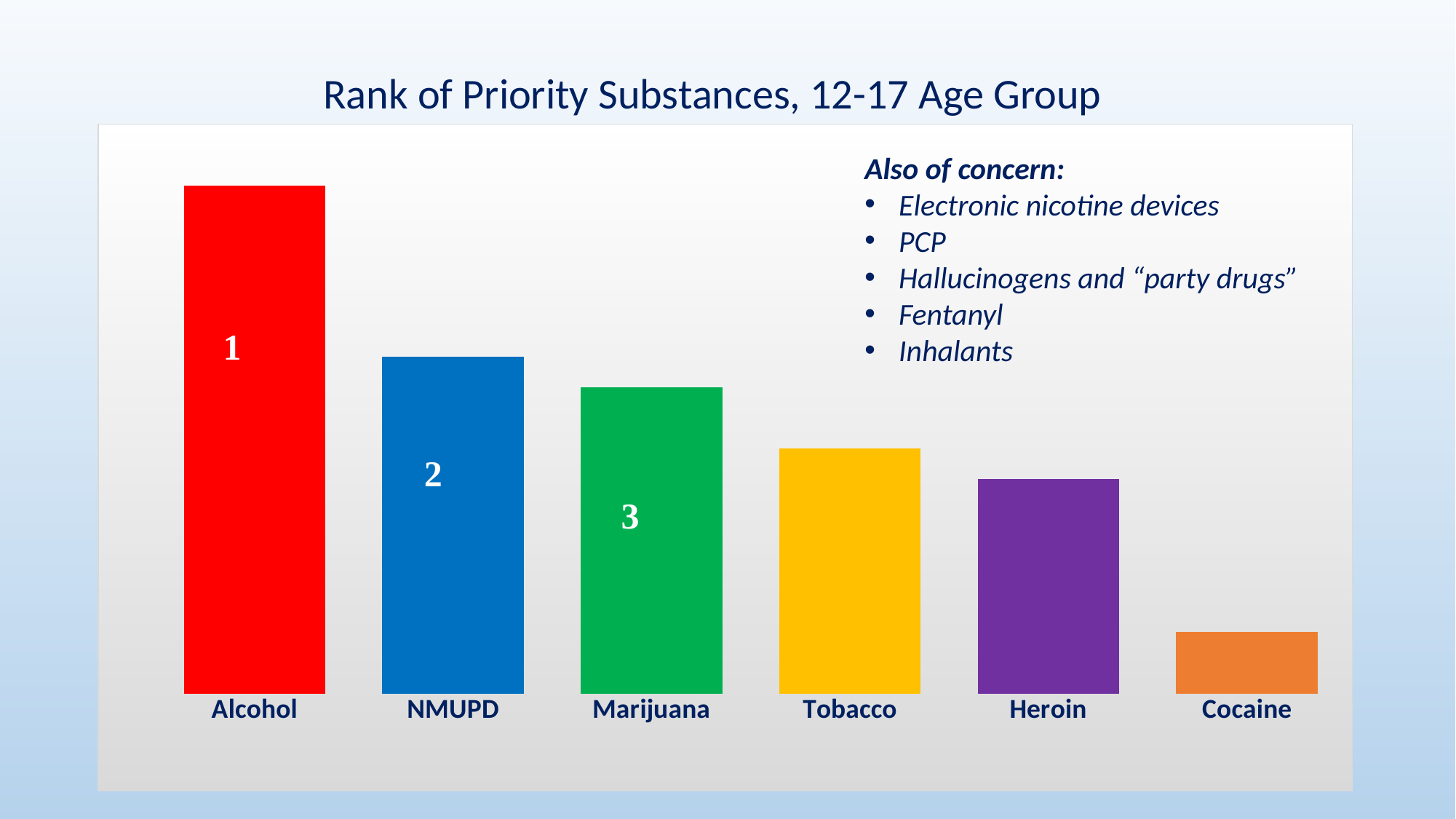
What rank number is printed on the Marijuana bar? 3 What rank number is printed on the NMUPD bar? 2 Which substance has the tallest bar in the chart? Alcohol Which substance has the shortest bar in the chart? Cocaine Do the bar heights rise or fall from left to right across the chart? fall How many substances are shown as bars in the chart? 6 What type of chart is shown on the slide? bar chart Which substance is ranked 2 in the chart? NMUPD What is the title of the chart? Rank of Priority Substances, 12-17 Age Group Which bar is taller, Tobacco or Heroin? Tobacco Which bar is taller, Marijuana or Cocaine? Marijuana What rank number is printed on the Alcohol bar? 1